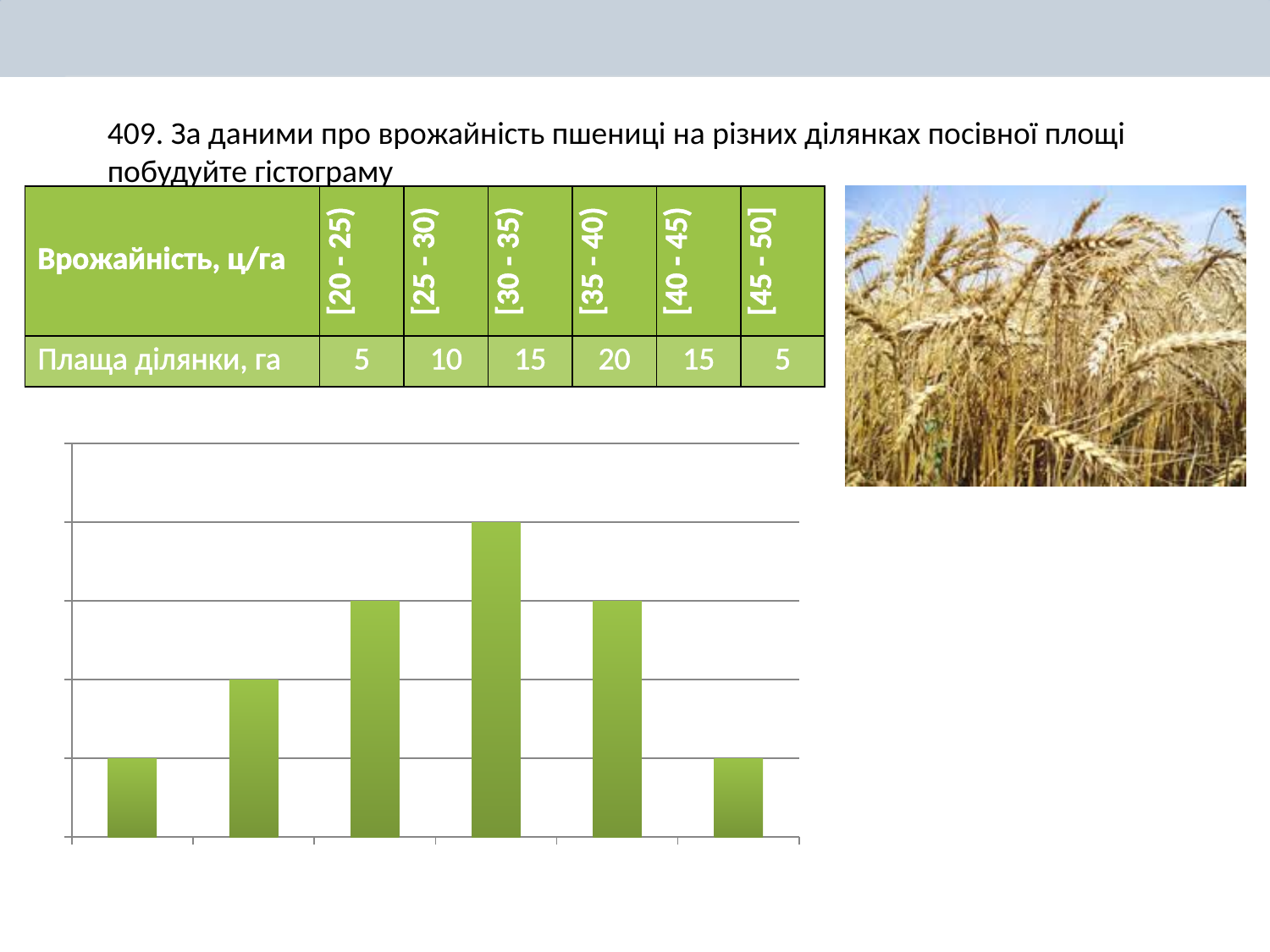
According to the table, what is the plot area (га) for the yield interval [45 - 50]? 5 Which bar in the chart is the tallest, counting from the left? the fourth bar What is the difference between the plot area for [35 - 40) and the plot area for [20 - 25)? 15 According to the table, what is the plot area (га) for the yield interval [25 - 30)? 10 According to the table, what is the plot area (га) for the yield interval [35 - 40)? 20 Which yield interval from the table corresponds to the tallest bar in the chart? [35 - 40) Do the bar heights rise or fall from the fourth bar to the sixth bar? fall Do the bar heights rise or fall from the first bar to the fourth bar? rise What kind of chart is shown on the slide? bar chart What colour are the bars in the chart? green How many bars does the chart contain? 6 Which is larger: the plot area for [30 - 35) or for [25 - 30)? [30 - 35)